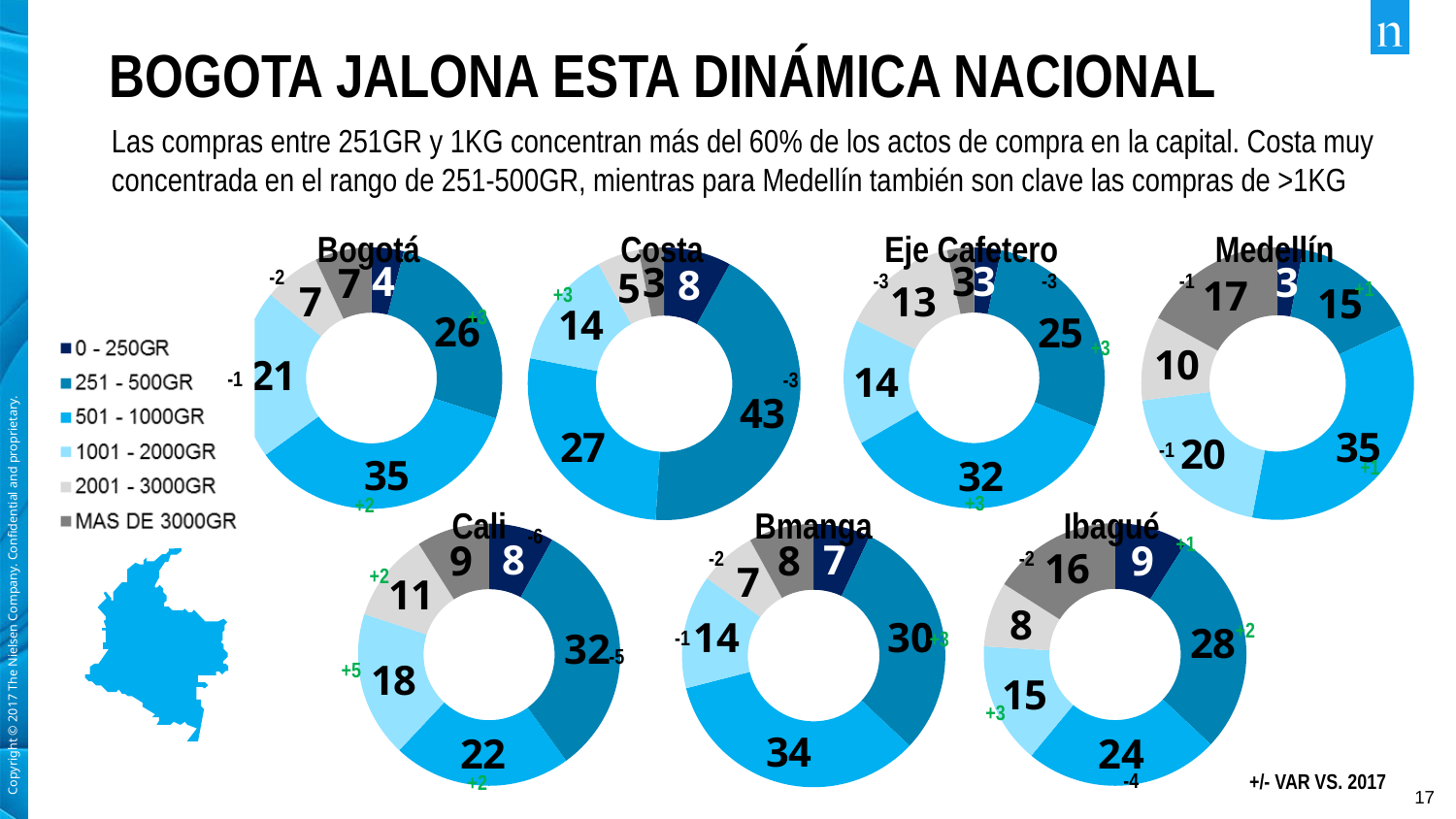
What type of chart is used for each city on the slide? Donut chart In the Costa chart, what is the value for the 251 - 500GR segment? 43 How many categories does the legend list? 6 In the Medellín chart, which segment has the lowest value? 0 - 250GR In the Cali chart, which segment has the highest value? 251 - 500GR In the Ibagué chart, what is the value for the 1001 - 2000GR segment? 15 In the Bogotá chart, which is larger: the 251 - 500GR segment or the 1001 - 2000GR segment? 251 - 500GR How many donut charts are shown on the slide? 7 In the Medellín chart, what is the value for the MAS DE 3000GR segment? 17 In the Bmanga chart, what is the difference between the 501 - 1000GR value and the 251 - 500GR value? 4 In the Bogotá chart, what is the value for the 501 - 1000GR segment? 35 In the Costa chart, what is the difference between the 251 - 500GR value and the 501 - 1000GR value? 16